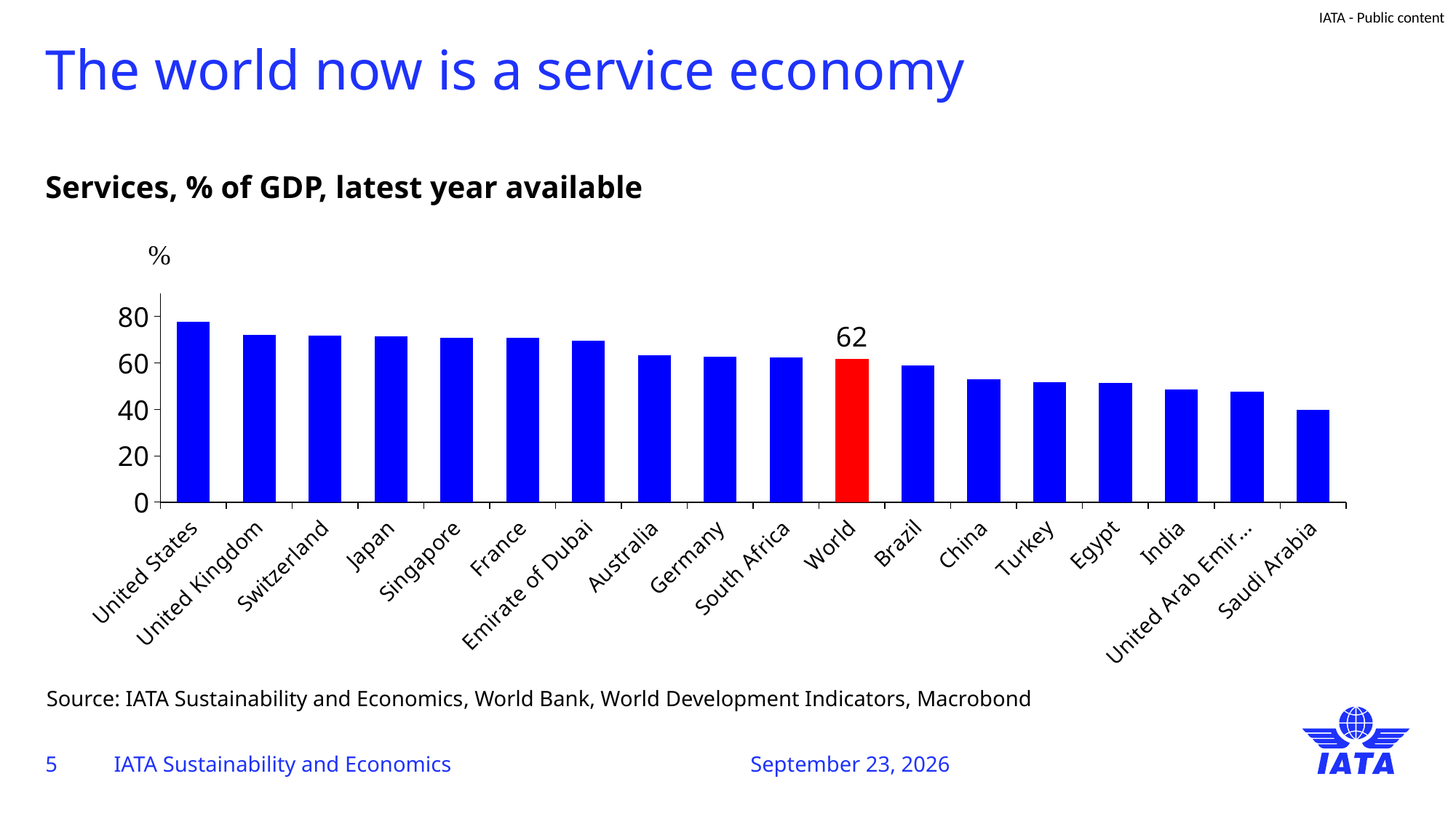
Which bar is coloured red? World What kind of chart is shown on the slide? Bar chart Do the values rise or fall moving from left to right along the x axis? Fall How many bars are plotted in the chart? 18 Which country has the highest services share of GDP? United States Is the value for China greater or less than 60? less Which country has the lowest services share of GDP? Saudi Arabia Is the value for the United States greater or less than 60? greater What is the title of the chart? Services, % of GDP, latest year available Which has a larger value, Japan or India? Japan Is the value for Saudi Arabia greater or less than 60? less What is the value for World? 62